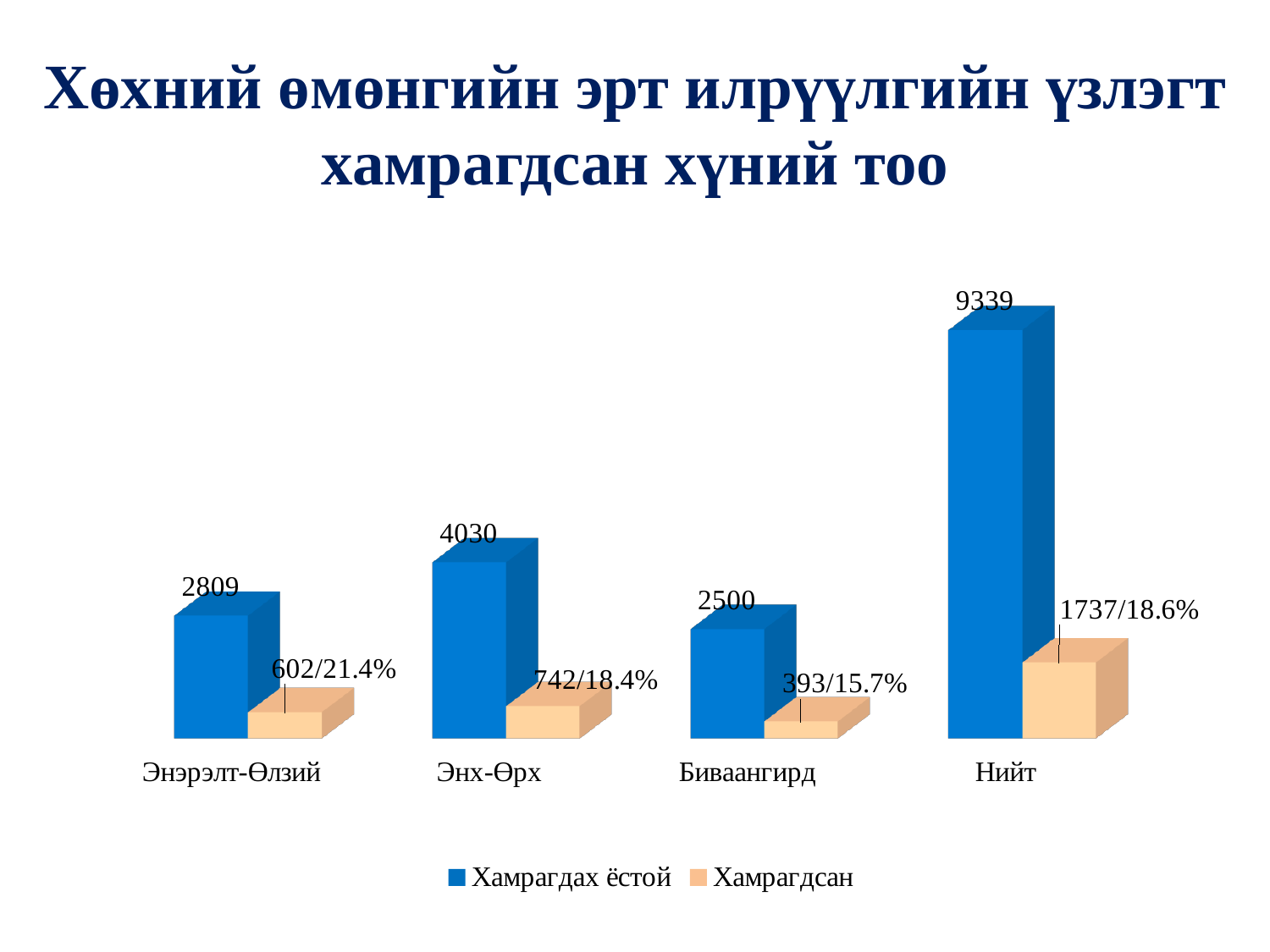
Which series is shown in blue according to the legend? Хамрагдах ёстой What data label is shown for Хамрагдсан at Нийт? 1737/18.6% How many series does the legend list? 2 What is the value of Хамрагдах ёстой for Биваангирд? 2500 What data label is shown for Хамрагдсан at Энэрэлт-Өлзий? 602/21.4% How many categories are shown on the x axis? 4 Which category has the highest Хамрагдах ёстой value? Нийт What is the difference between the Хамрагдах ёстой values for Энх-Өрх and Энэрэлт-Өлзий? 1221 Which is larger: the Хамрагдах ёстой value for Энэрэлт-Өлзий or for Биваангирд? Энэрэлт-Өлзий What kind of chart is shown on the slide? Bar chart What is the value of Хамрагдах ёстой for Энх-Өрх? 4030 Among the three districts (excluding Нийт), which has the lowest Хамрагдах ёстой value? Биваангирд